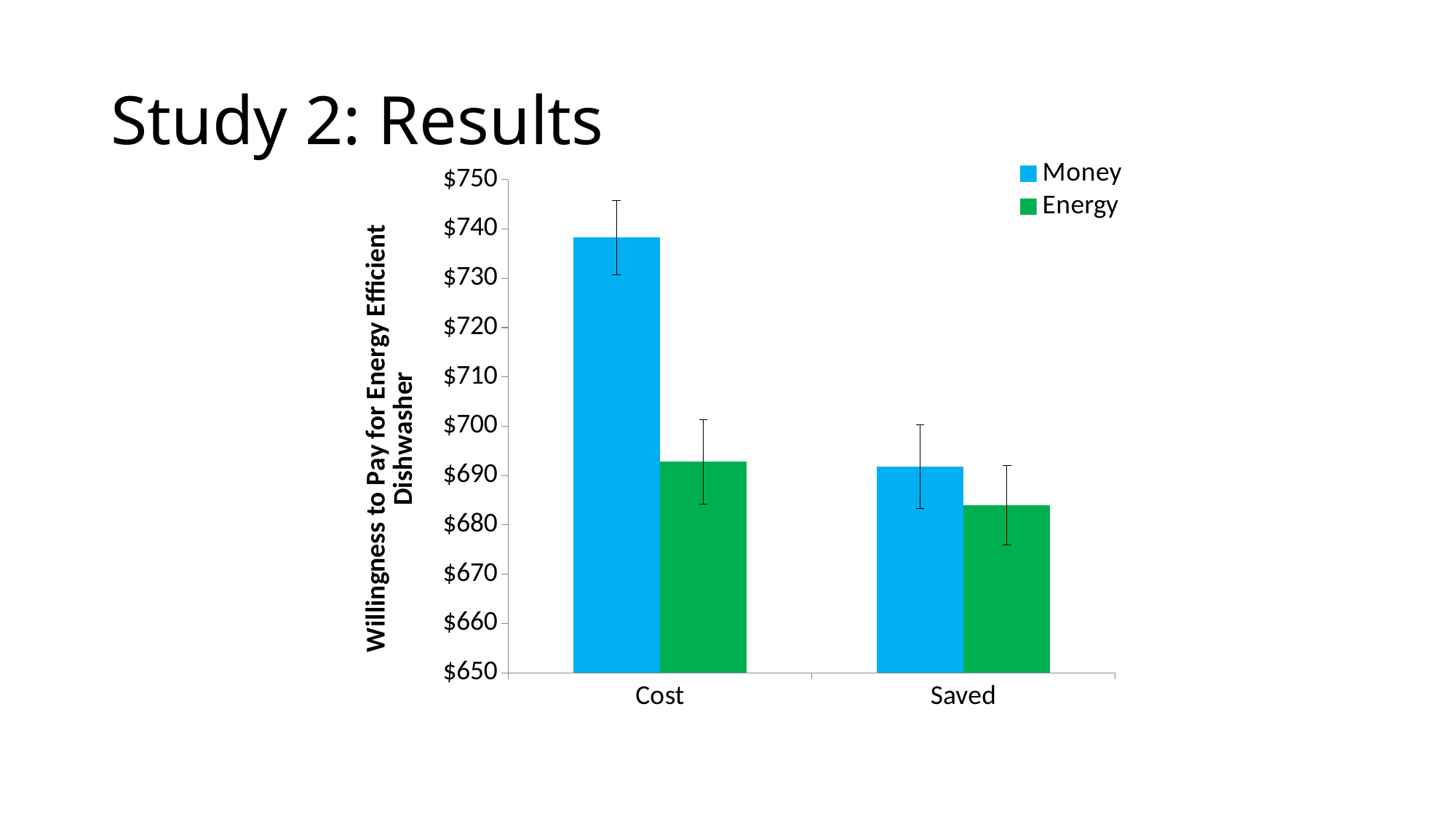
Is the value for Money in the Cost category greater or less than $730? greater Which bar is the highest in the chart? Money, Cost Is the value for Money in the Saved category greater or less than $700? less For the Money series, which category has the larger value, Cost or Saved? Cost Is the value for Energy in the Saved category greater or less than $690? less In the Cost category, which series has the larger value, Money or Energy? Money How many series does the legend list? 2 How many categories are shown on the x axis? 2 What is the label of the vertical axis? Willingness to Pay for Energy Efficient Dishwasher What kind of chart is shown on the slide? bar chart Which bar is the lowest in the chart? Energy, Saved